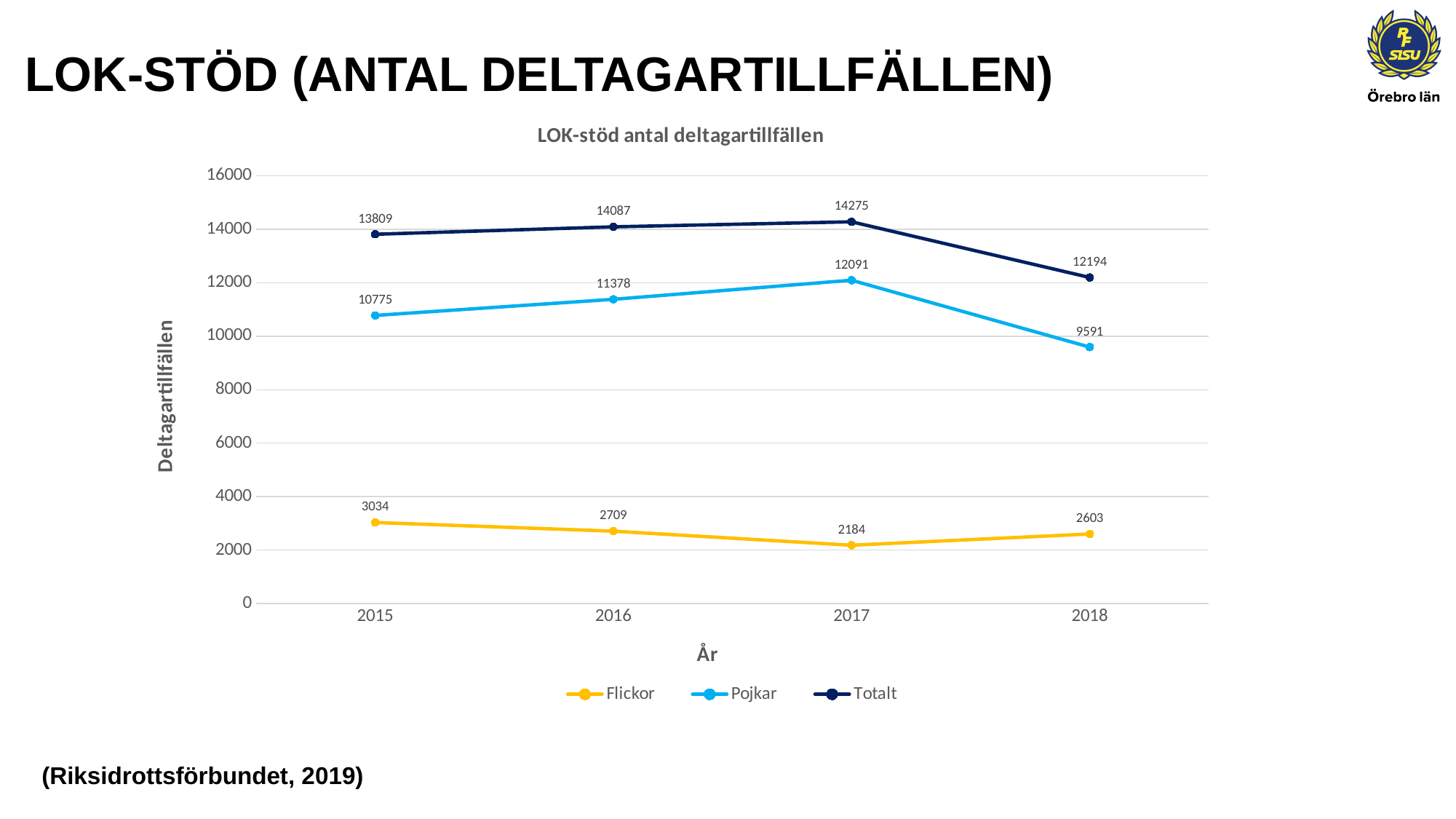
What is the value for Flickor in 2015? 3034 What is the value for Totalt in 2018? 12194 Does the Pojkar series rise or fall from 2015 to 2017? rise Is the value for Pojkar in 2018 greater or less than 10000? less What kind of chart is shown? line chart In which year is the Totalt series highest? 2017 Which is larger, the Flickor value in 2016 or in 2018? 2016 What is the value for Pojkar in 2017? 12091 In which year is the Flickor series lowest? 2017 What is the difference between the Pojkar values in 2017 and 2018? 2500 How many years are shown on the x axis? 4 How many series does the legend list? 3